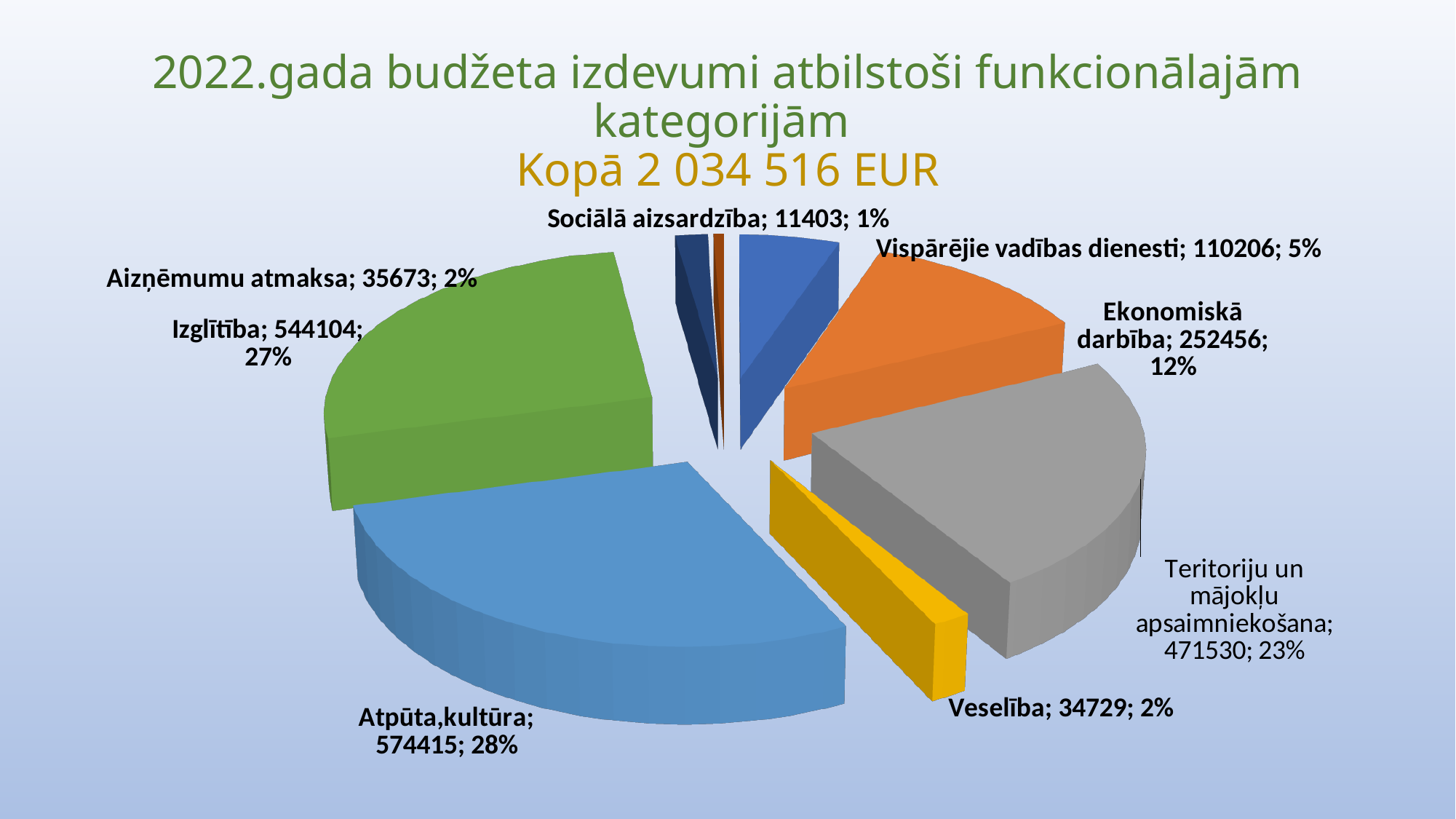
How many categories does the pie chart show? 8 Which category has the largest share of the pie? Atpūta,kultūra What percentage share does Vispārējie vadības dienesti have? 5% What is the difference between the values for Atpūta,kultūra and Izglītība? 30311 Which is larger, the value for Vispārējie vadības dienesti or the value for Veselība? Vispārējie vadības dienesti Which category has the smallest share of the pie? Sociālā aizsardzība What is the value for Ekonomiskā darbība? 252456 What is the value for Aizņēmumu atmaksa? 35673 What is the value for Izglītība? 544104 What kind of chart is shown on the slide? pie chart What percentage share does Teritoriju un mājokļu apsaimniekošana have? 23% What total amount is stated in the chart title? 2 034 516 EUR